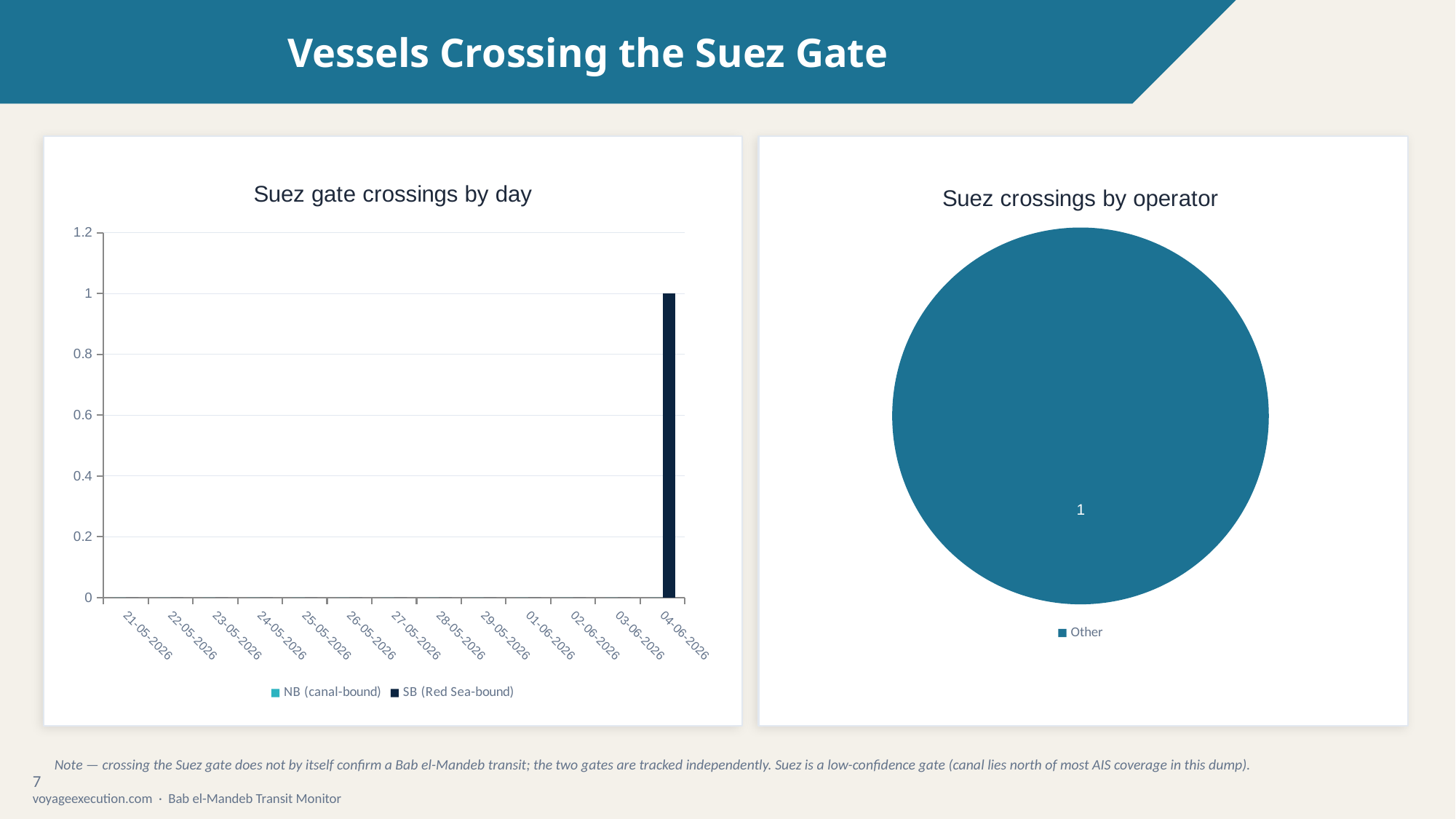
In the 'Suez gate crossings by day' chart, which series does the only visible bar belong to? SB (Red Sea-bound) In the 'Suez gate crossings by day' chart, how many dates are shown on the x axis? 13 In the 'Suez gate crossings by day' chart, what is the SB (Red Sea-bound) value on 04-06-2026? 1 What kind of chart is the 'Suez gate crossings by day' chart on the left? bar chart In the 'Suez crossings by operator' pie chart, how many slices are there? 1 In the 'Suez gate crossings by day' chart, how many series does the legend list? 2 In the 'Suez gate crossings by day' chart, is the value on 04-06-2026 greater or less than 0.8? greater In the 'Suez gate crossings by day' chart, what are the two legend entries? NB (canal-bound) and SB (Red Sea-bound) In the 'Suez gate crossings by day' chart, which date has the highest number of crossings? 04-06-2026 What kind of chart is the 'Suez crossings by operator' chart on the right? pie chart In the 'Suez crossings by operator' pie chart, what share of the pie does Other represent? 100% In the 'Suez crossings by operator' pie chart, what value is shown for Other? 1